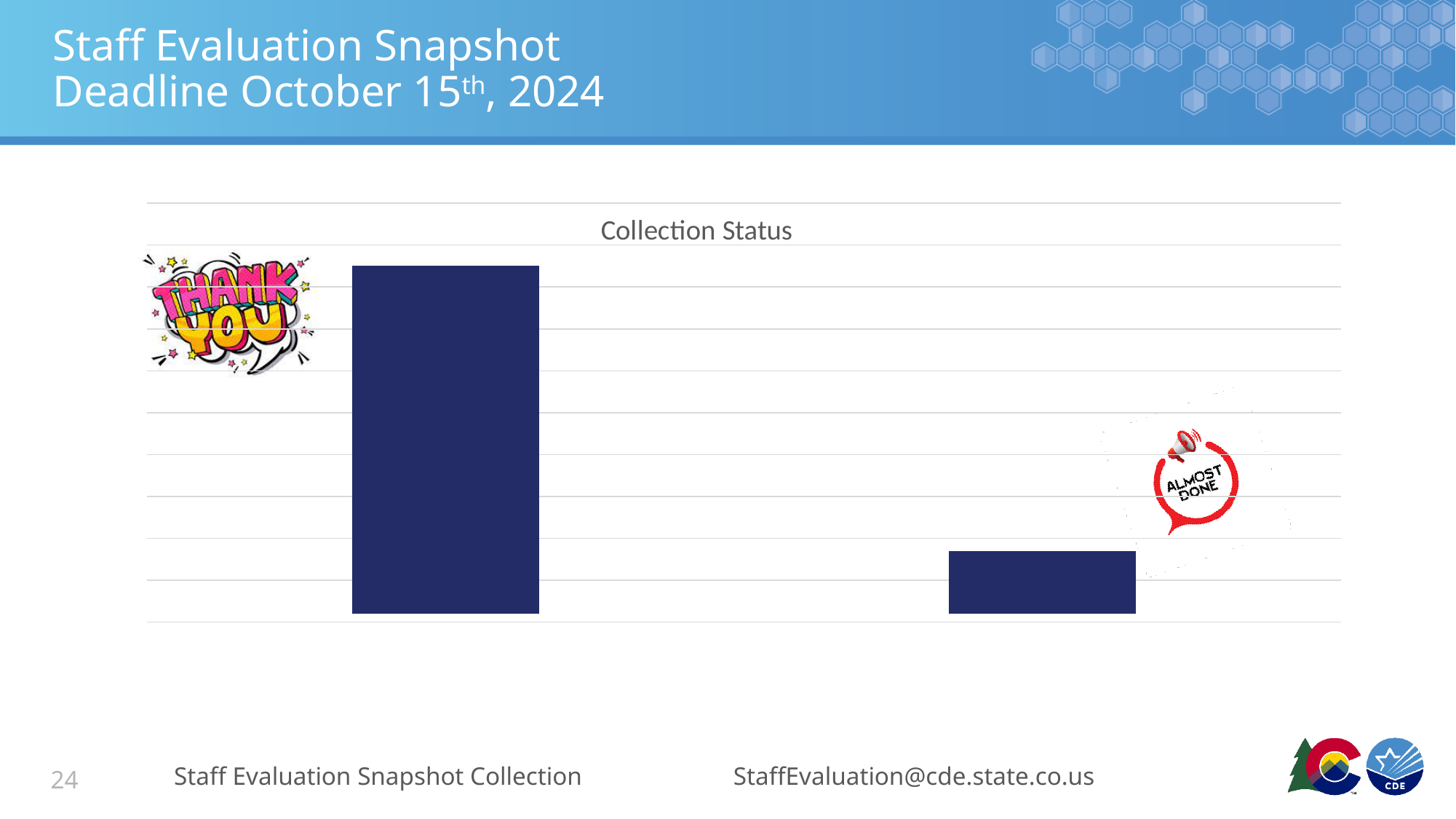
Which bar in the chart is the tallest? the left bar What kind of chart is shown on the slide? bar chart Which bar in the chart is the shortest? the right bar What colour are the bars in the chart? dark navy blue Which bar is taller, the left bar or the right bar? the left bar What is the title of the chart? Collection Status How many bars are plotted in the chart? 2 Do the bar heights rise or fall from left to right across the chart? fall